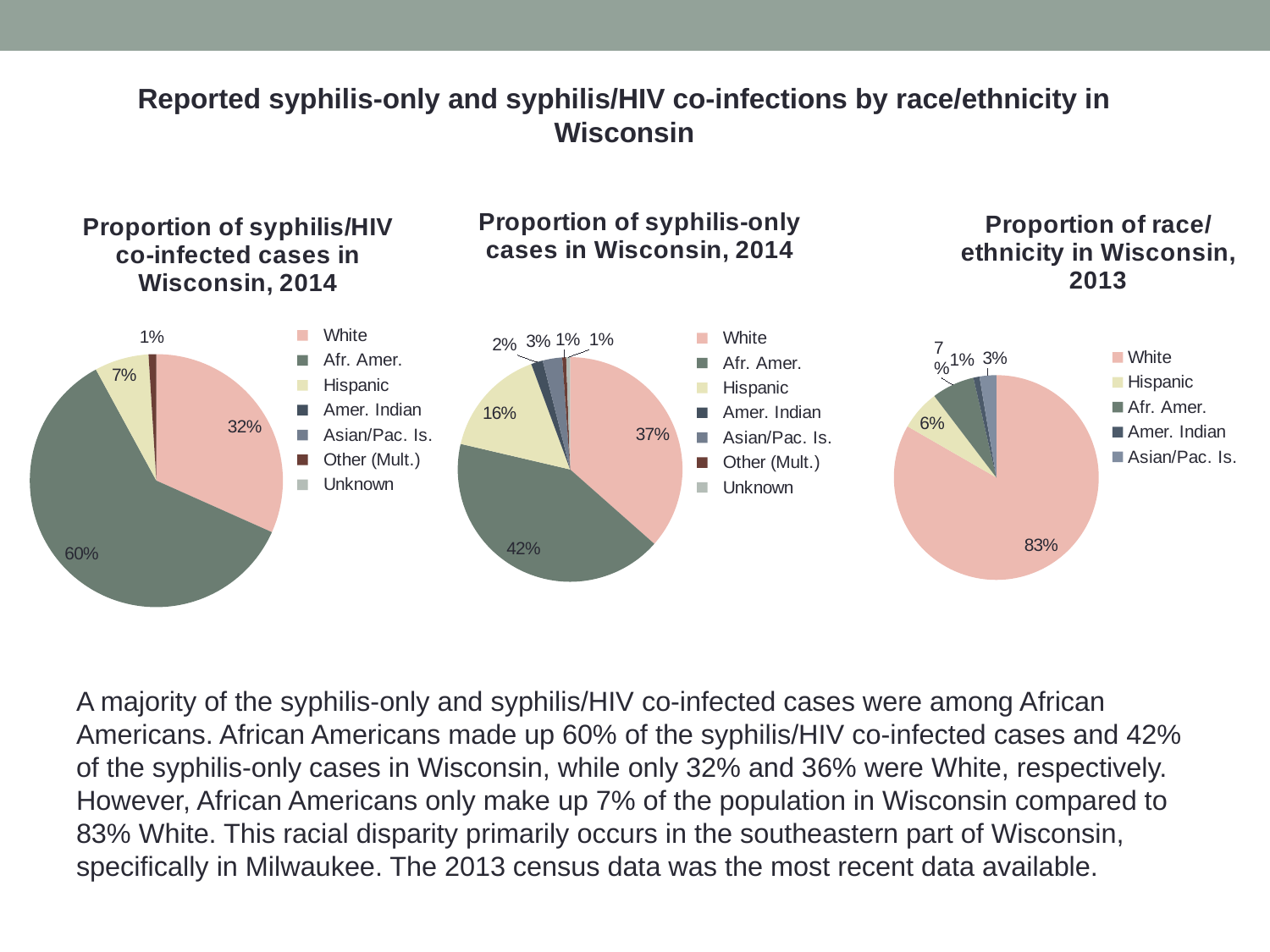
How many entries does the legend of the 'Proportion of race/ethnicity in Wisconsin, 2013' chart list? 5 In the 'Proportion of race/ethnicity in Wisconsin, 2013' chart, what share is Afr. Amer.? 7% In the 'Proportion of syphilis-only cases in Wisconsin, 2014' chart, what share of cases is Hispanic? 16% In the 'Proportion of syphilis-only cases in Wisconsin, 2014' chart, what is the difference between the Afr. Amer. and White shares? 5% In the 'Proportion of syphilis-only cases in Wisconsin, 2014' chart, which group has the largest slice? Afr. Amer. In the 'Proportion of syphilis/HIV co-infected cases in Wisconsin, 2014' chart, which is larger, the Hispanic slice or the White slice? White In the 'Proportion of race/ethnicity in Wisconsin, 2013' chart, which group has the smallest slice? Amer. Indian In the 'Proportion of race/ethnicity in Wisconsin, 2013' chart, what share is White? 83% In the 'Proportion of syphilis/HIV co-infected cases in Wisconsin, 2014' chart, what share of cases is Afr. Amer.? 60% In the 'Proportion of syphilis/HIV co-infected cases in Wisconsin, 2014' chart, what share of cases is White? 32% How many entries does the legend of the 'Proportion of syphilis-only cases in Wisconsin, 2014' chart list? 7 What type of chart is the 'Proportion of race/ethnicity in Wisconsin, 2013' chart? Pie chart